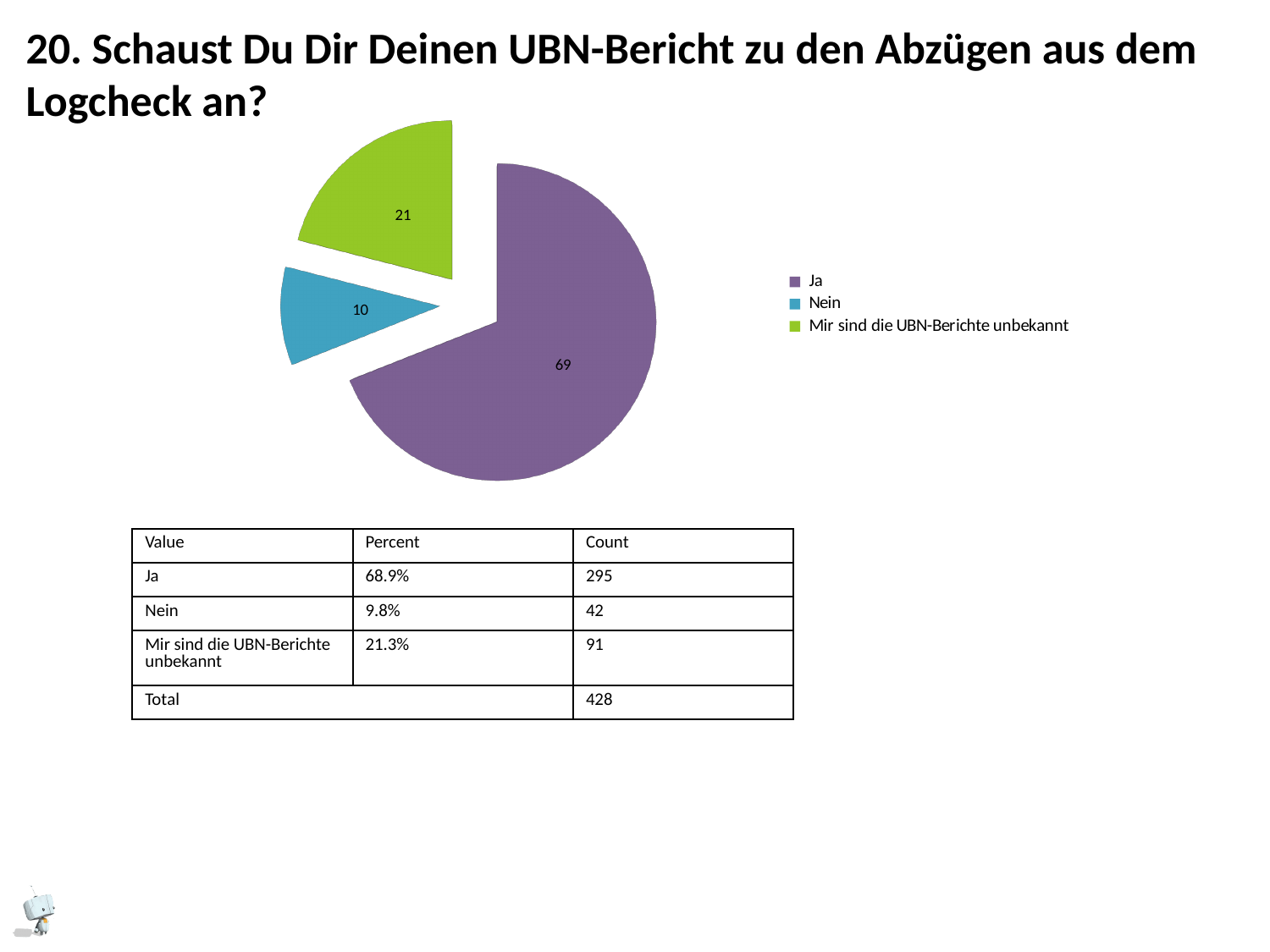
Which category has the smallest slice of the pie? Nein Which category has the largest slice of the pie? Ja What kind of chart is shown on the slide? pie chart What colour is the slice for "Ja"? purple How many entries does the legend list? 3 What is the difference between the labelled values for "Mir sind die UBN-Berichte unbekannt" and "Nein"? 11 How many slices does the pie chart have? 3 What value is labelled on the pie slice for "Ja"? 69 What is the difference between the labelled values for "Ja" and "Nein"? 59 What value is labelled on the pie slice for "Mir sind die UBN-Berichte unbekannt"? 21 What value is labelled on the pie slice for "Nein"? 10 Which slice is larger, "Nein" or "Mir sind die UBN-Berichte unbekannt"? Mir sind die UBN-Berichte unbekannt